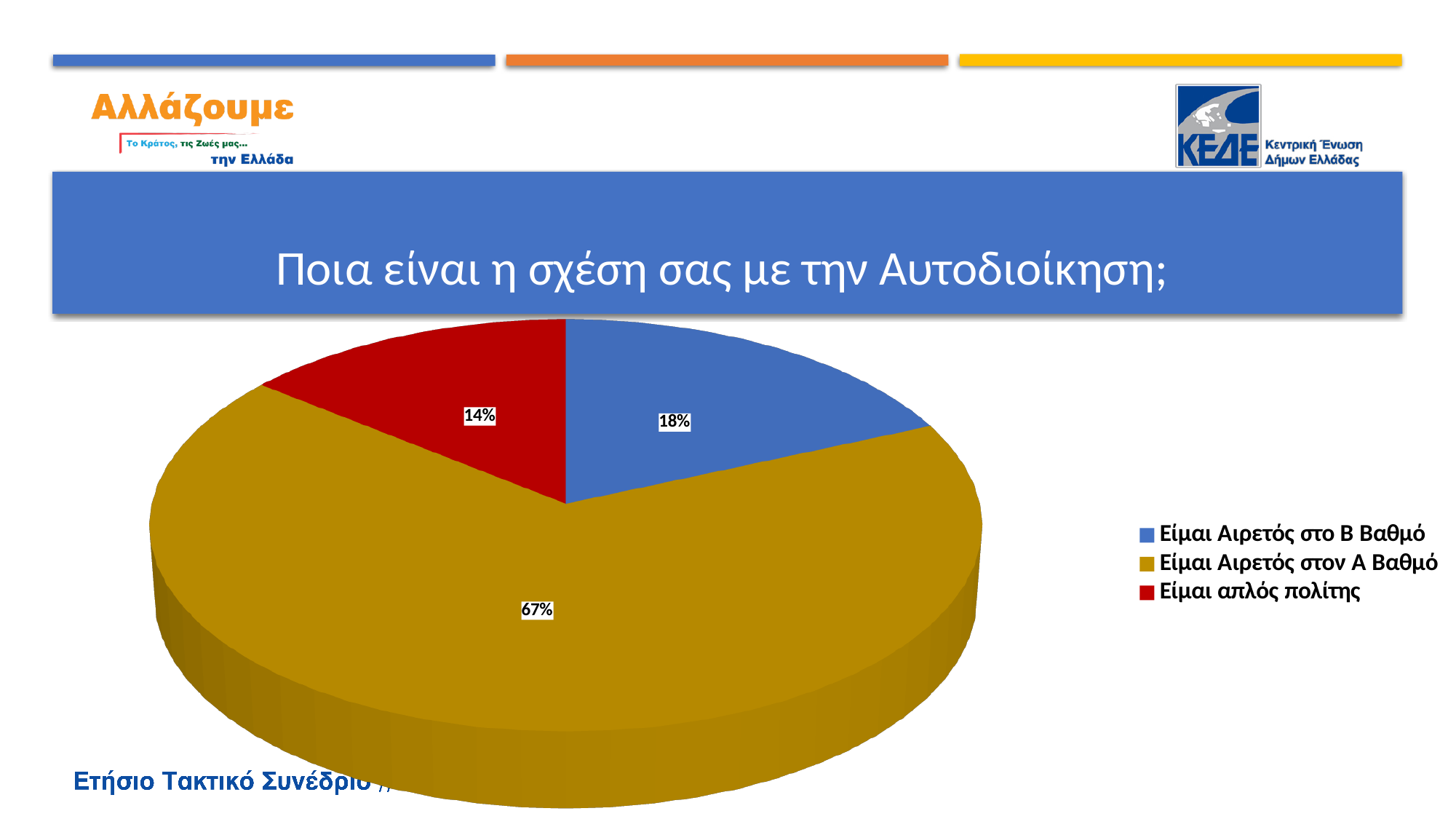
What is the title of the chart? Ποια είναι η σχέση σας με την Αυτοδιοίκηση; Which category has the largest slice of the pie? Είμαι Αιρετός στον Α Βαθμό Which is larger: the slice for "Είμαι Αιρετός στο Β Βαθμό" or the slice for "Είμαι απλός πολίτης"? Είμαι Αιρετός στο Β Βαθμό What is the difference in percentage points between "Είμαι Αιρετός στον Α Βαθμό" and "Είμαι Αιρετός στο Β Βαθμό"? 49 percentage points What share of the pie is labelled "Είμαι Αιρετός στον Α Βαθμό"? 67% What colour is the slice for "Είμαι απλός πολίτης"? Red What share of the pie is labelled "Είμαι απλός πολίτης"? 14% What is the difference in percentage points between "Είμαι Αιρετός στο Β Βαθμό" and "Είμαι απλός πολίτης"? 4 percentage points Which category has the smallest slice of the pie? Είμαι απλός πολίτης How many categories does the pie chart show? 3 What share of the pie is labelled "Είμαι Αιρετός στο Β Βαθμό"? 18% What kind of chart is shown on the slide? Pie chart